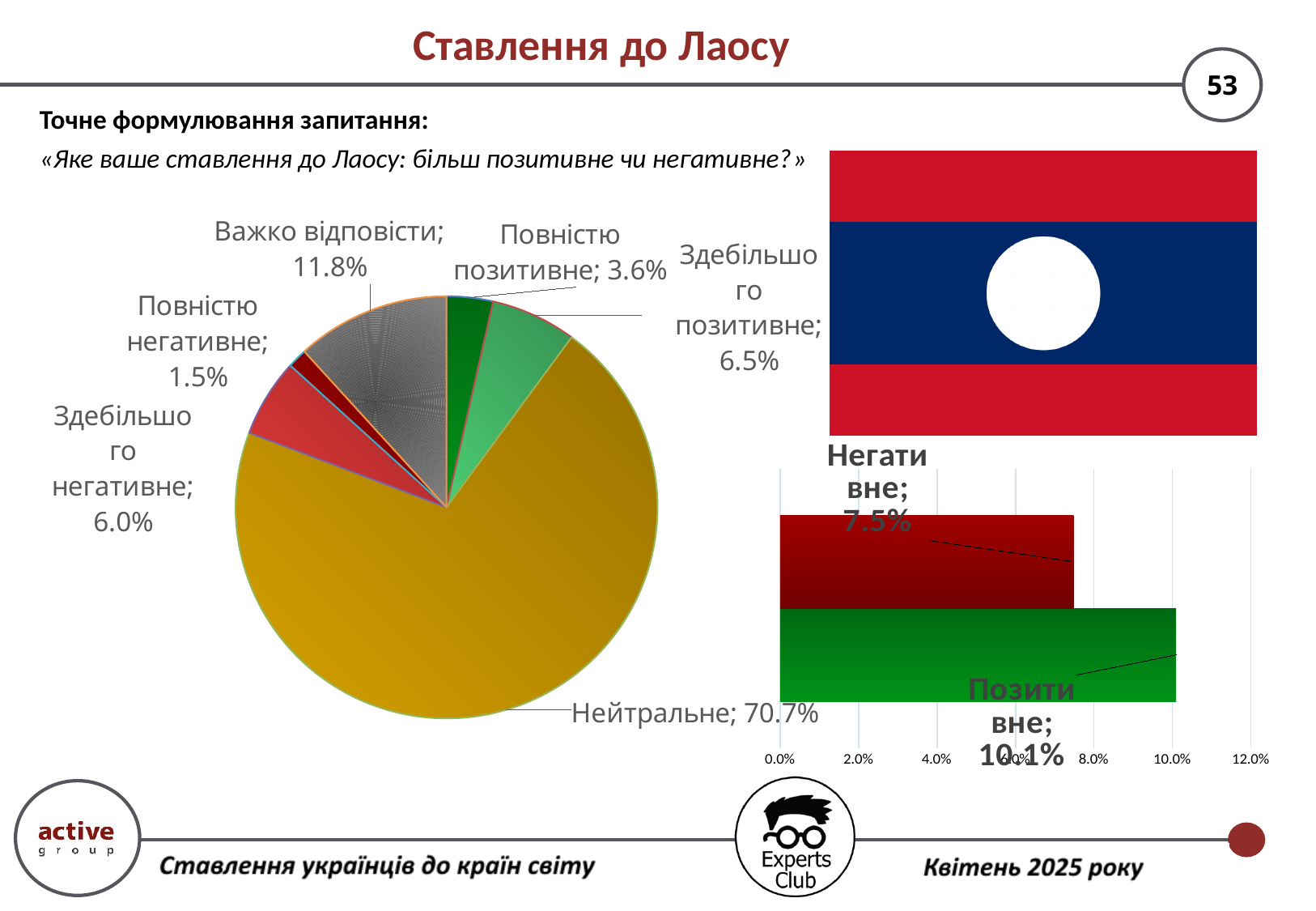
What type of chart is shown on the right below the flag? Bar chart On the bar chart, what is the value for «Негативне»? 7.5% On the pie chart, what is the difference between «Здебільшого позитивне» and «Здебільшого негативне»? 0.5% On the pie chart, what share of respondents answered «Нейтральне»? 70.7% On the pie chart, what is the value for «Повністю позитивне»? 3.6% On the pie chart, what is the value for «Важко відповісти»? 11.8% On the pie chart, what is the value for «Здебільшого негативне»? 6.0% On the pie chart, which category has the smallest share? Повністю негативне On the pie chart, how many categories are shown? 6 On the bar chart, what is the value for «Позитивне»? 10.1% On the bar chart, which is larger: «Позитивне» or «Негативне»? Позитивне On the pie chart, which category has the largest share? Нейтральне